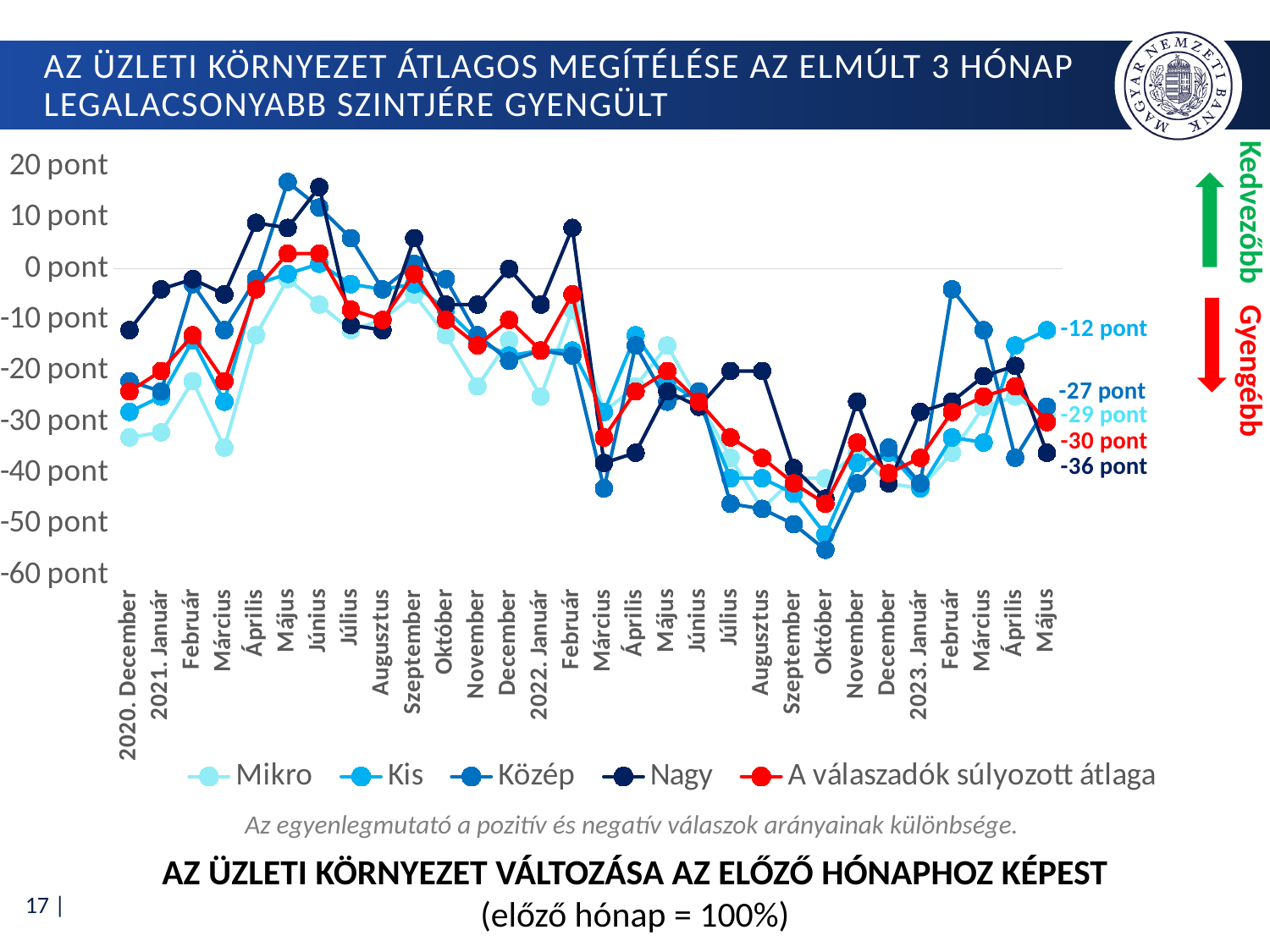
Which series has the highest value in 2023 Május? Kis What is the value of the Mikro series in 2023 Május? -29 pont What kind of chart is shown on the slide? line chart What is the value of the Közép series in 2023 Május? -27 pont Which series is plotted in red? A válaszadók súlyozott átlaga What is the value of the Nagy series in 2023 Május? -36 pont What is the difference between the Kis and Nagy values in 2023 Május? 24 pont How many series does the legend list? 5 What is the value of 'A válaszadók súlyozott átlaga' in 2023 Május? -30 pont What is the value of the Kis series in 2023 Május? -12 pont Is the value for the Nagy series in 2022 Október greater or less than -50 pont? greater Which series has the lowest value in 2023 Május? Nagy